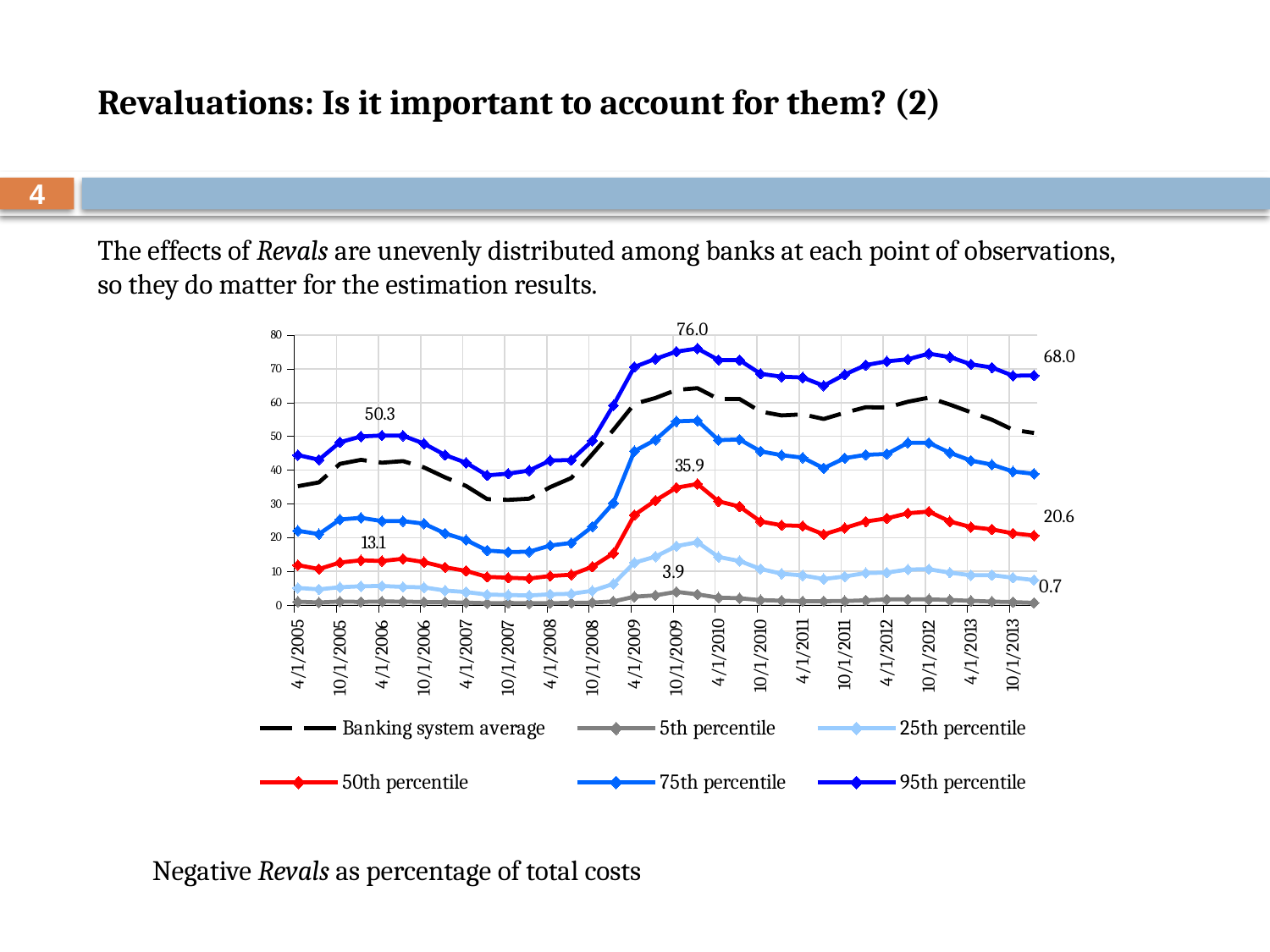
How many series does the chart legend list? 6 Which series is the highest across the whole chart? 95th percentile What is the final value labelled at the right end of the 50th percentile line? 20.6 Which series is drawn as a dashed black line? Banking system average What is the final value labelled at the right end of the 5th percentile line? 0.7 What is the final value labelled at the right end of the 95th percentile line? 68.0 What is the peak value labelled on the 95th percentile line? 76.0 What is the peak value labelled on the 5th percentile line? 3.9 What type of chart is shown on the slide? line chart What is the difference between the labelled peak of the 95th percentile line (76.0) and its labelled final value (68.0)? 8.0 Is the Banking system average at 10/1/2009 greater or less than 60? greater What is the peak value labelled on the 50th percentile line? 35.9